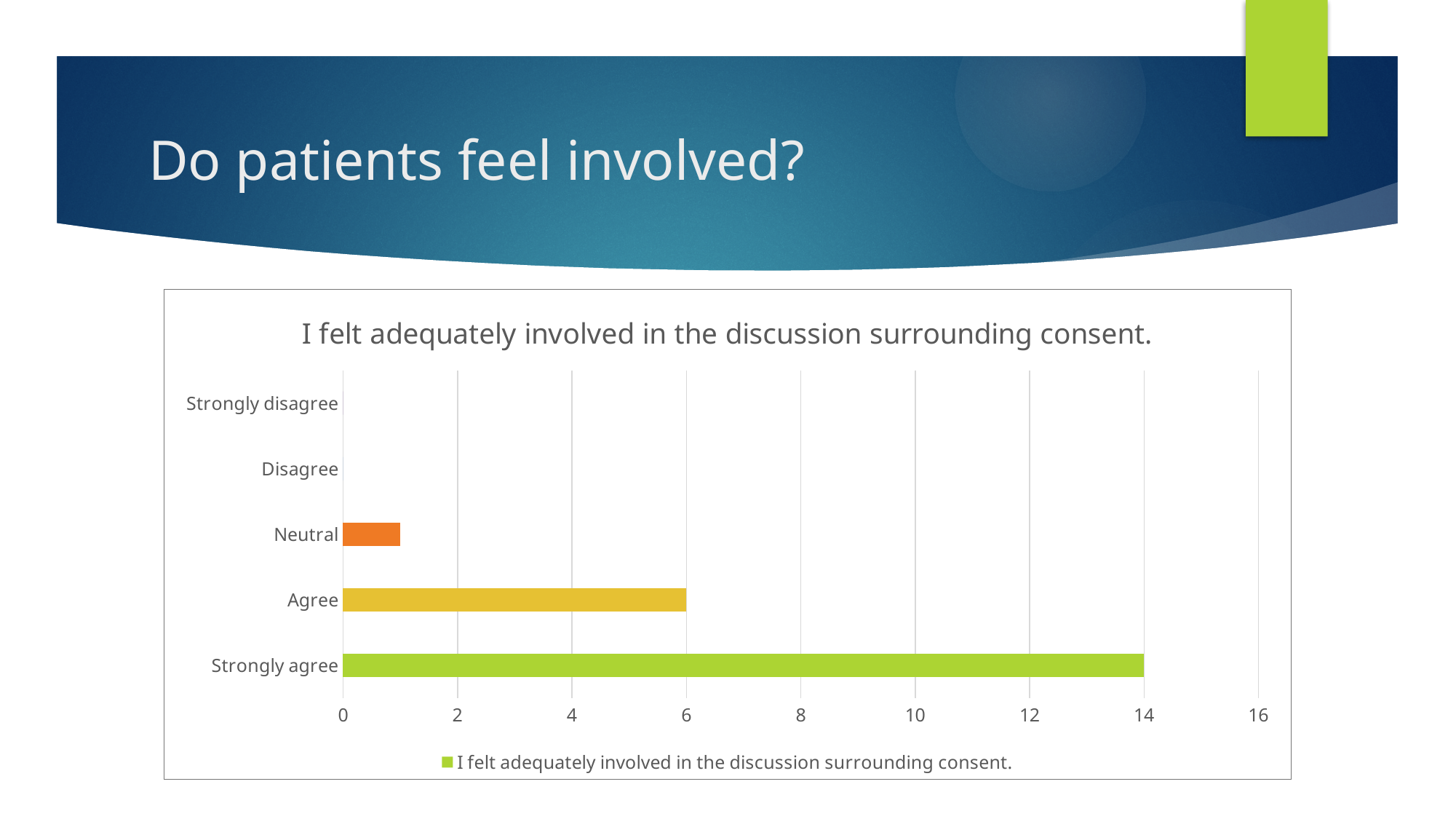
What is the difference between the values for Strongly agree and Agree? 8 Which category has the highest value? Strongly agree Is the value for Neutral greater or less than 2? less What is the value for Strongly agree? 14 What is the value for Agree? 6 How many series does the chart legend list? 1 Which is larger, the value for Agree or the value for Neutral? Agree What kind of chart is shown on the slide? bar chart Which category has the smallest visible bar? Neutral What colour is the bar for Strongly agree? green How many response categories are listed on the vertical axis of the chart? 5 What is the title of the chart? I felt adequately involved in the discussion surrounding consent.